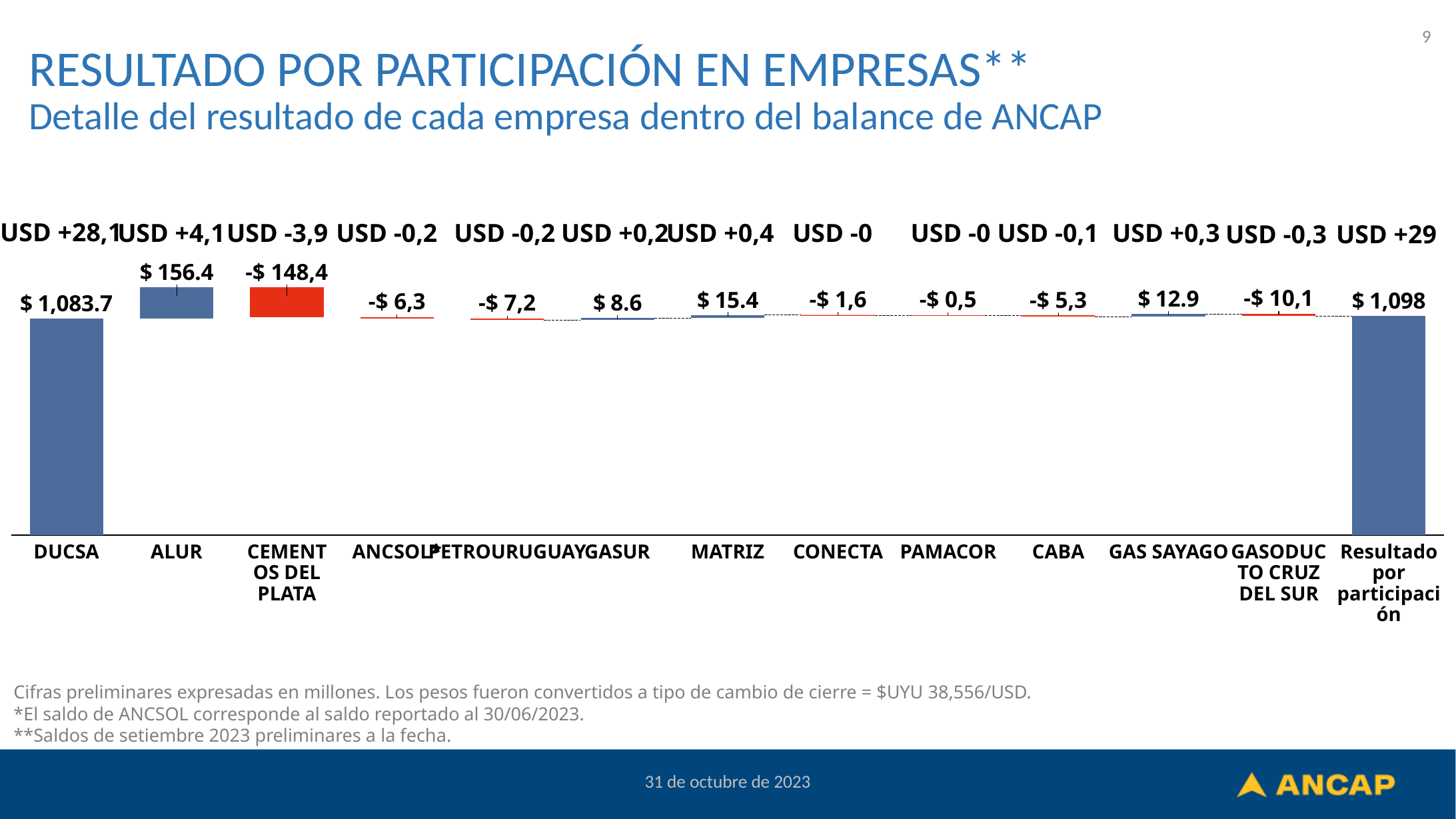
What is the value shown for CEMENTOS DEL PLATA? -$ 148,4 How many categories are shown on the x axis? 13 What is the difference between the values for MATRIZ and GASUR? 6.8 What is the value shown for DUCSA? $ 1,083.7 What is the value shown for the final bar, Resultado por participación? $ 1,098 What colour are the bars with negative values? Red Which is larger, the value for ALUR or the value for GASUR? ALUR What USD figure is shown above the GAS SAYAGO bar? USD +0,3 What is the value shown for ALUR? $ 156.4 Which company has the lowest (most negative) value? CEMENTOS DEL PLATA Which individual company has the highest value? DUCSA What is the value shown for MATRIZ? $ 15.4